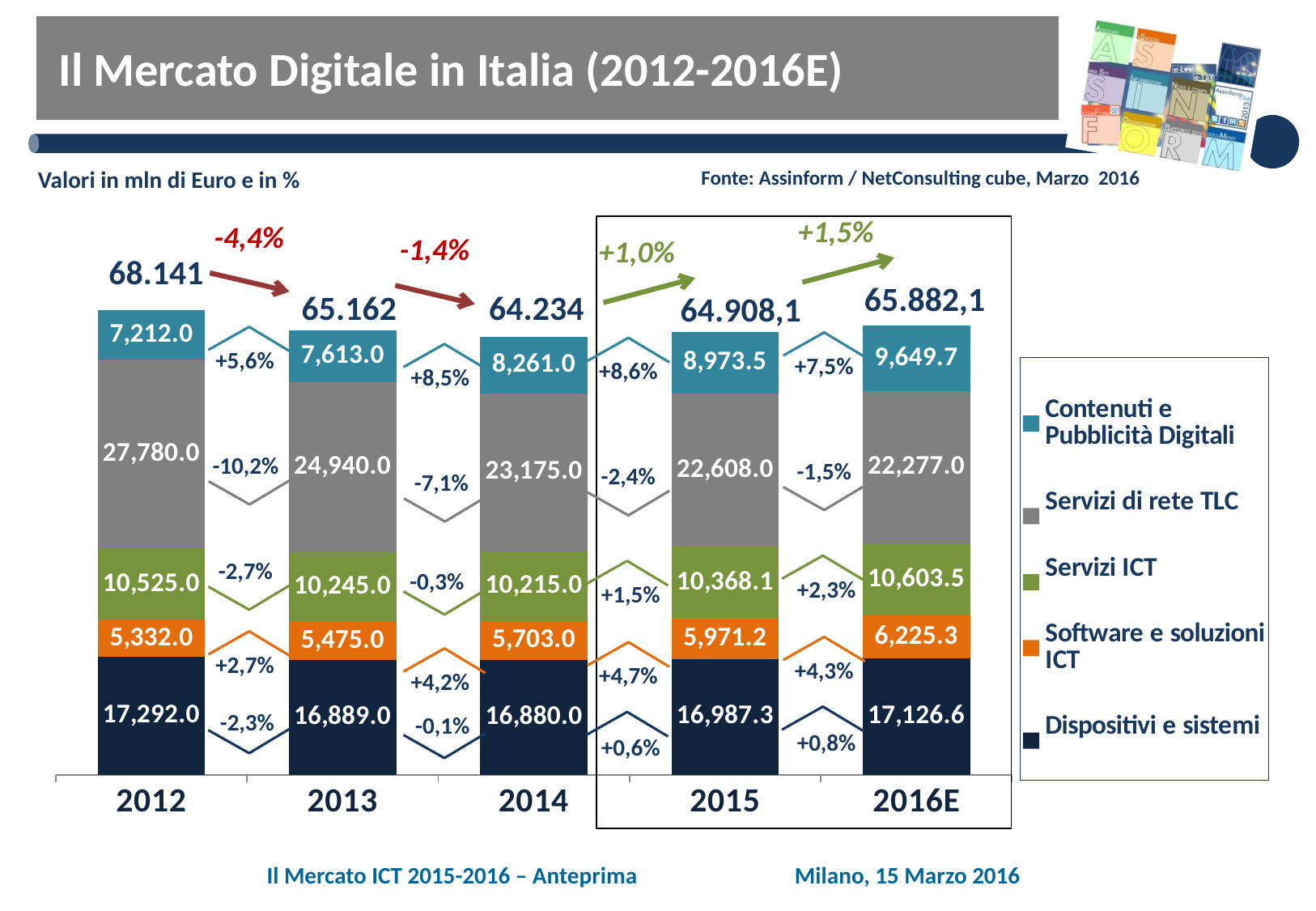
What is the total of the stacked bar for 2015? 64.908,1 Does the value for Contenuti e Pubblicità Digitali rise or fall from 2012 to 2016E? Rise What is the value for Servizi di rete TLC in 2013? 24,940.0 Which year has the highest total market value? 2012 What kind of chart is shown on the slide? Stacked bar chart Which is larger in 2012: Servizi di rete TLC or Dispositivi e sistemi? Servizi di rete TLC What is the difference between Software e soluzioni ICT in 2016E and in 2015? 254.1 Which year has the lowest total market value? 2014 What is the value for Contenuti e Pubblicità Digitali in 2012? 7,212.0 How many series does the legend list? 5 What is the value for Dispositivi e sistemi in 2016E? 17,126.6 How many years are shown on the x axis? 5